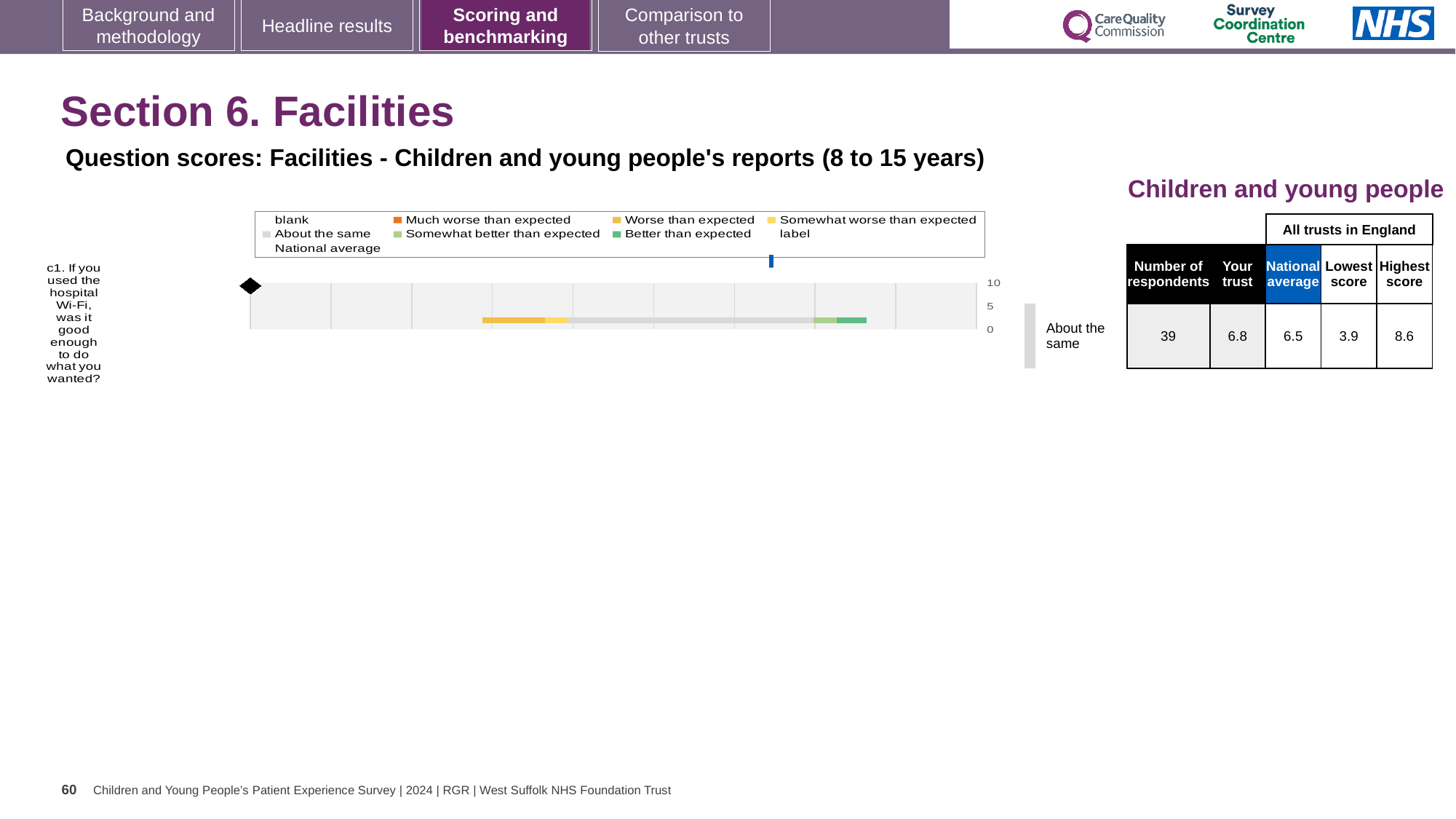
What is the maximum value shown on the chart's score axis? 10 Which is larger for question c1: the 'Your trust' score or the national average? Your trust What is the 'Your trust' score for question c1 about the hospital Wi-Fi? 6.8 What is the national average score for question c1 about the hospital Wi-Fi? 6.5 What is the difference between the 'Your trust' score and the national average for question c1? 0.3 What is the lowest score among all trusts in England for question c1? 3.9 What is the difference between the highest and lowest scores among all trusts in England for question c1? 4.7 How many respondents answered question c1 about the hospital Wi-Fi? 39 What kind of chart is shown on the slide? bar chart How many survey questions are plotted in the chart? 1 What benchmark category is the trust's result for question c1 placed in? About the same What is the highest score among all trusts in England for question c1? 8.6